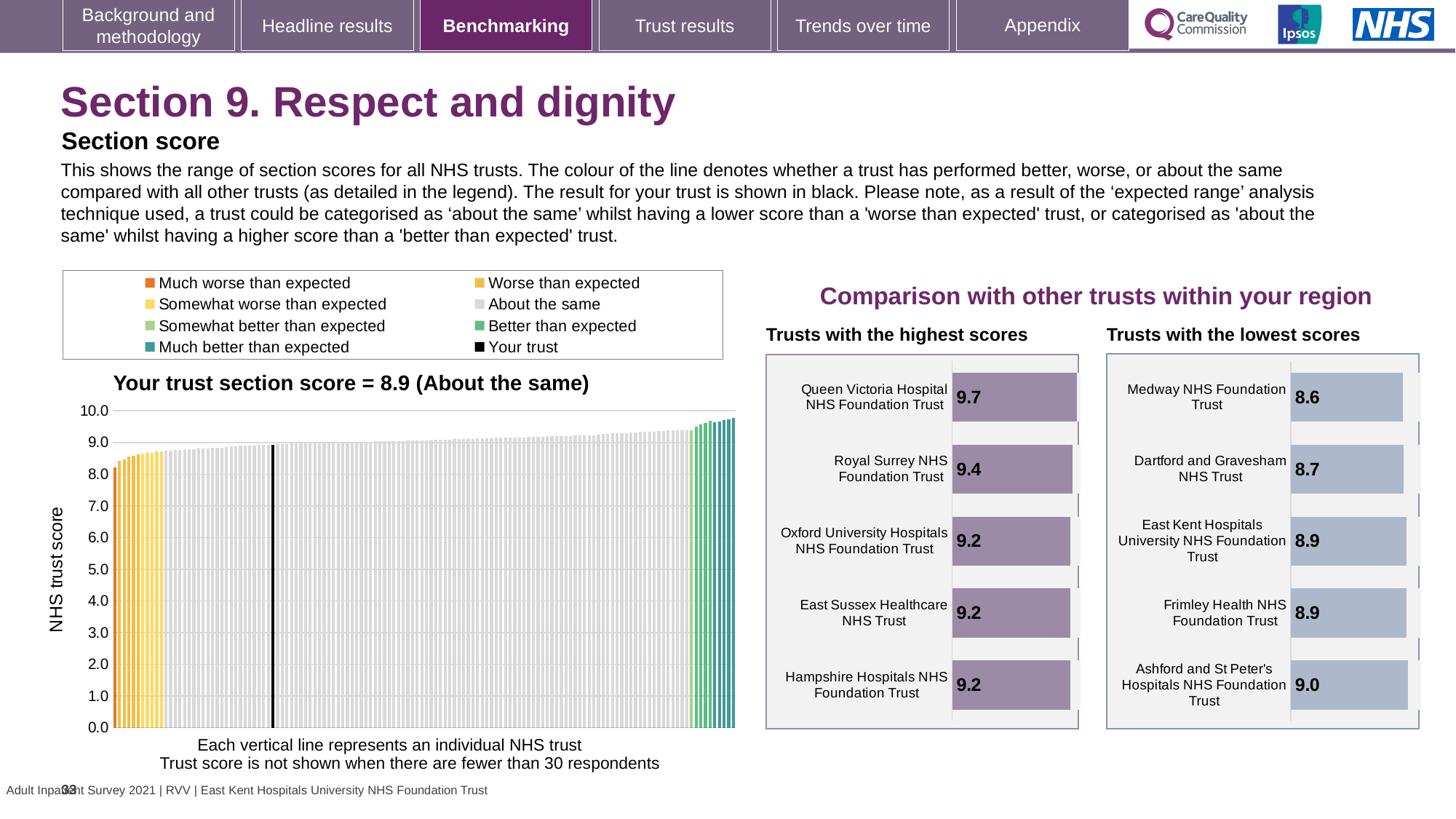
In the 'Trusts with the highest scores' chart, which trust has the highest score? Queen Victoria Hospital NHS Foundation Trust In the 'Trusts with the highest scores' chart, what is the score for Royal Surrey NHS Foundation Trust? 9.4 In the 'Trusts with the highest scores' chart, what is the score for Queen Victoria Hospital NHS Foundation Trust? 9.7 In the 'Trusts with the lowest scores' chart, which trust has the lowest score? Medway NHS Foundation Trust In the 'Trusts with the lowest scores' chart, what is the score for Medway NHS Foundation Trust? 8.6 In the 'Trusts with the highest scores' chart, what is the difference between the scores of Queen Victoria Hospital NHS Foundation Trust and Royal Surrey NHS Foundation Trust? 0.3 In the 'Trusts with the lowest scores' chart, which has the larger score: Dartford and Gravesham NHS Trust or Medway NHS Foundation Trust? Dartford and Gravesham NHS Trust In the chart titled 'Your trust section score = 8.9 (About the same)', what kind of chart is shown? Bar chart In the 'Trusts with the lowest scores' chart, what is the difference between the scores of Ashford and St Peter's Hospitals NHS Foundation Trust and Medway NHS Foundation Trust? 0.4 In the 'Trusts with the highest scores' chart, how many trusts are listed? 5 In the chart titled 'Your trust section score = 8.9 (About the same)', do the trust scores rise or fall from left to right along the x axis? Rise In the chart titled 'Your trust section score = 8.9 (About the same)', how many entries does the legend list? 8